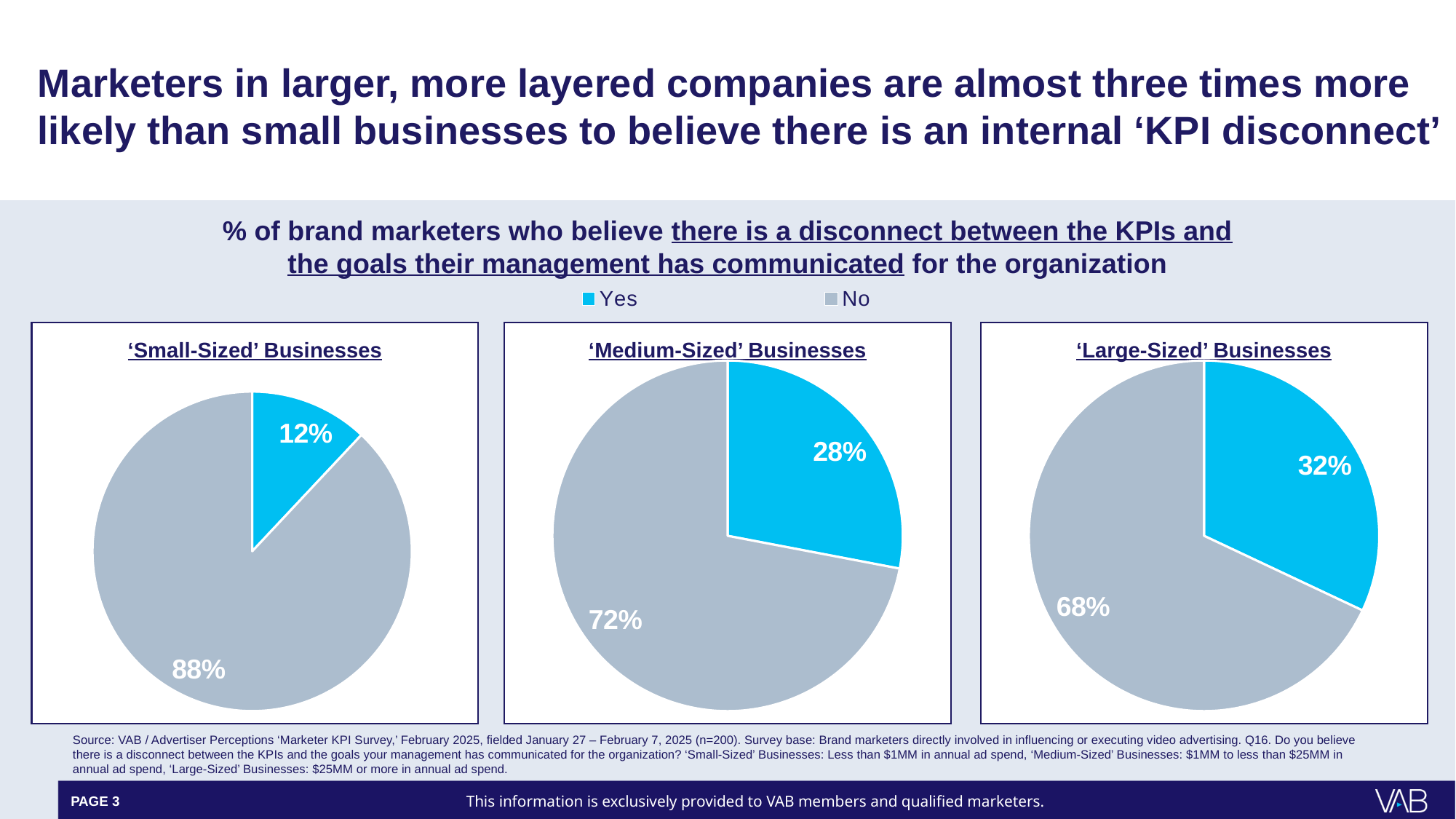
Is the Yes share larger for 'Medium-Sized' Businesses or for 'Small-Sized' Businesses? 'Medium-Sized' Businesses Across the three pie charts, which business size has the highest Yes share? 'Large-Sized' Businesses What type of chart is used for each of the three business sizes? Pie chart Which colour represents the 'Yes' response in the pie charts? Blue In the 'Small-Sized' Businesses pie chart, what percentage answered No? 88% How many entries does the legend list? 2 In the 'Medium-Sized' Businesses pie chart, what percentage answered No? 72% How many pie charts are shown on the slide? 3 Across the three pie charts, which business size has the lowest Yes share? 'Small-Sized' Businesses In the 'Small-Sized' Businesses pie chart, what percentage answered Yes? 12% What is the difference between the Yes share for 'Large-Sized' Businesses and the Yes share for 'Small-Sized' Businesses? 20 percentage points In the 'Large-Sized' Businesses pie chart, what percentage answered Yes? 32%